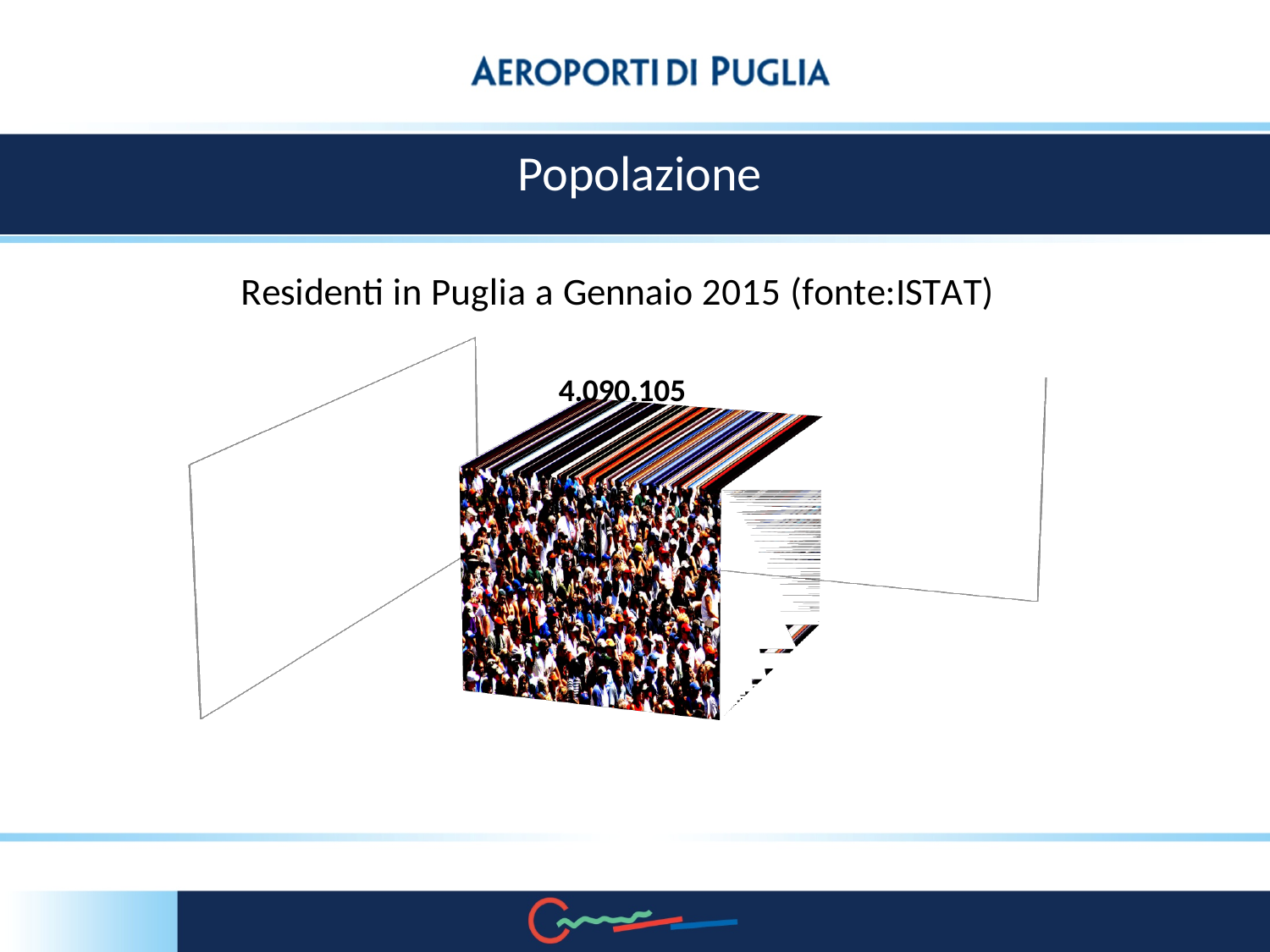
What is the bar in the chart filled with? a photo of a crowd of people How many bars are plotted in the chart? 1 What kind of chart is shown on the slide? bar chart What is the title of the chart? Residenti in Puglia a Gennaio 2015 (fonte:ISTAT) Is the value shown on the bar greater or less than 4.000.000? greater What value is printed as the data label on the bar in the chart? 4.090.105